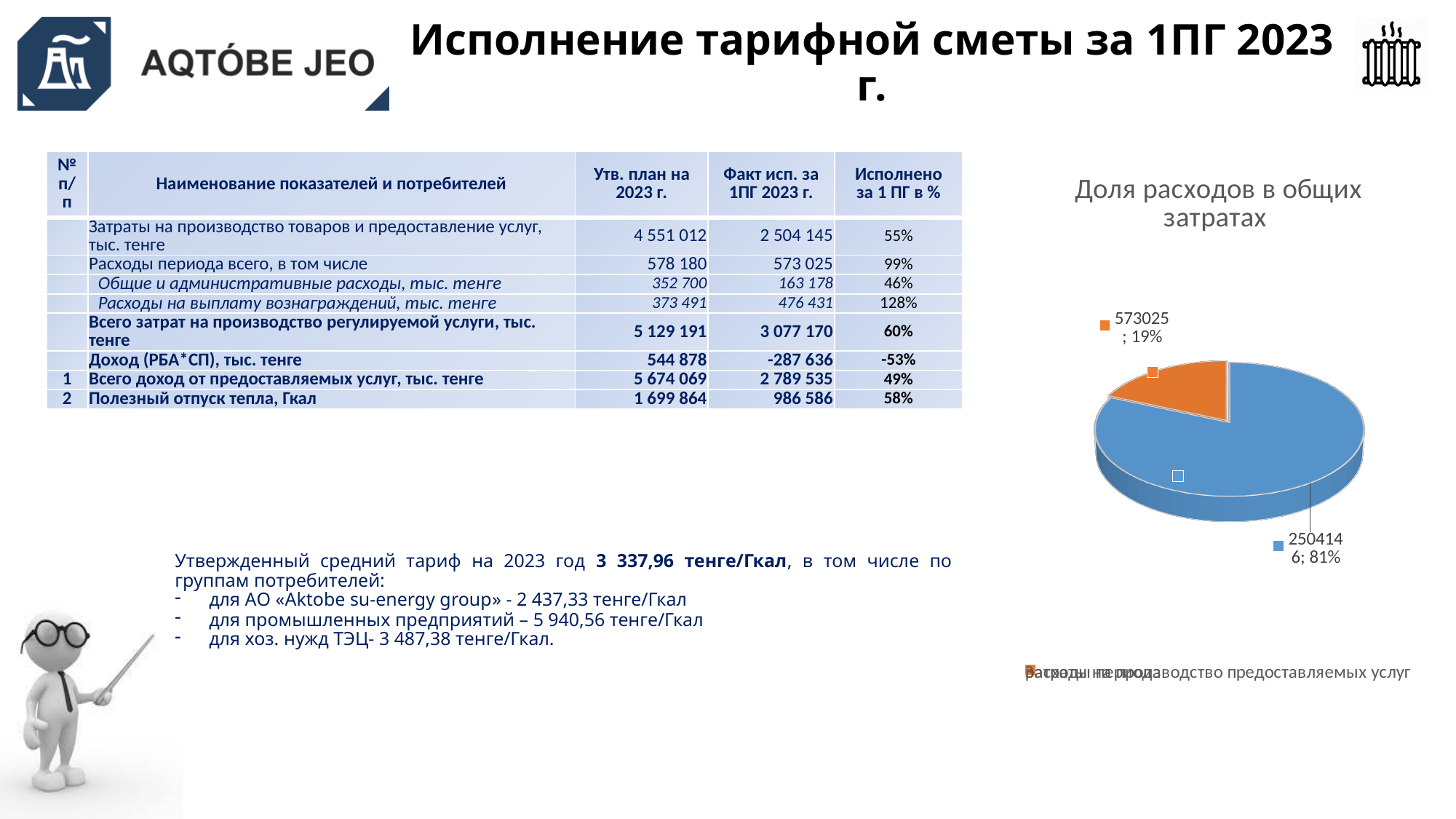
In the pie chart "Доля расходов в общих затратах", by how many percentage points does the blue slice's share exceed the orange slice's share? 62 percentage points What is the title of the pie chart on the slide? Доля расходов в общих затратах In the pie chart "Доля расходов в общих затратах", what share does the orange slice represent? 19% What colour is the slice labelled 19% in the pie chart "Доля расходов в общих затратах"? orange How many slices does the pie chart "Доля расходов в общих затратах" have? 2 In the pie chart "Доля расходов в общих затратах", what value is labelled on the orange slice? 573025 In the pie chart "Доля расходов в общих затратах", is the orange slice larger or smaller than the blue slice? smaller In the pie chart "Доля расходов в общих затратах", which slice is the smallest? the orange slice (19%) In the pie chart "Доля расходов в общих затратах", what share does the blue slice represent? 81% In the pie chart "Доля расходов в общих затратах", which slice is the largest? the blue slice (81%) What kind of chart is shown on the right side of the slide under the title "Доля расходов в общих затратах"? pie chart